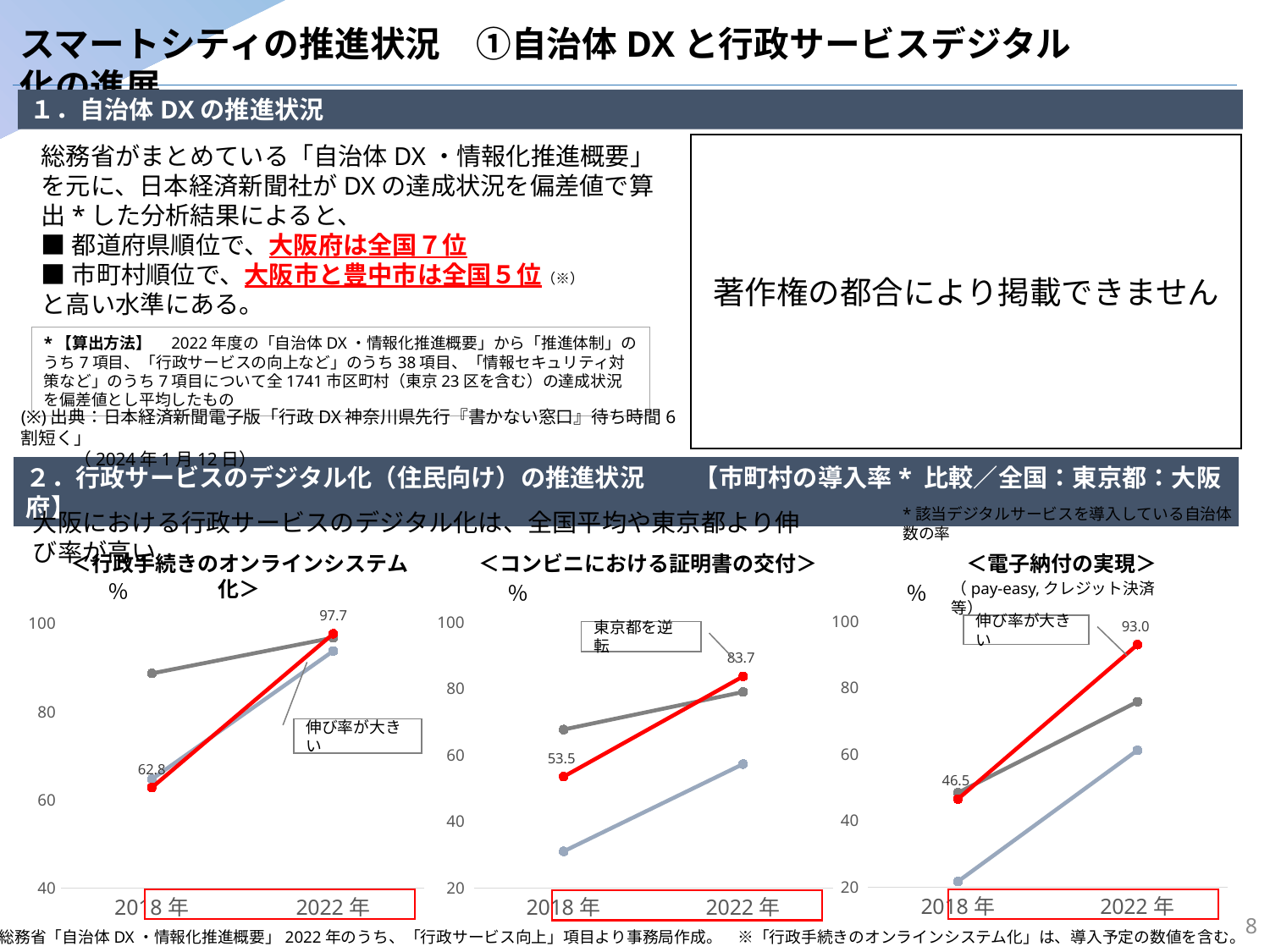
In the chart titled 電子納付の実現, what is the value of the red line in 2022年? 93.0 In the chart titled 電子納付の実現, which line has the higher value in 2022年, the red line or the dark gray line? the red line In the chart titled 行政手続きのオンラインシステム化, what is the value of the red line in 2022年? 97.7 In the chart titled 行政手続きのオンラインシステム化, what is the value of the red line in 2018年? 62.8 In the chart titled 行政手続きのオンラインシステム化, by how much did the red line increase from 2018年 to 2022年? 34.9 In the chart titled コンビニにおける証明書の交付, what is the value of the red line in 2022年? 83.7 How many years are shown on the x axis of the chart titled コンビニにおける証明書の交付? 2 What type of chart is used for the three charts at the bottom of the slide? line chart In the chart titled コンビニにおける証明書の交付, what is the value of the red line in 2018年? 53.5 In the chart titled 電子納付の実現, does the red line rise or fall from 2018年 to 2022年? rise In the chart titled 行政手続きのオンラインシステム化, is the 2018年 value of the dark gray line greater or less than 80? greater In the chart titled 電子納付の実現, by how much did the red line increase from 2018年 to 2022年? 46.5